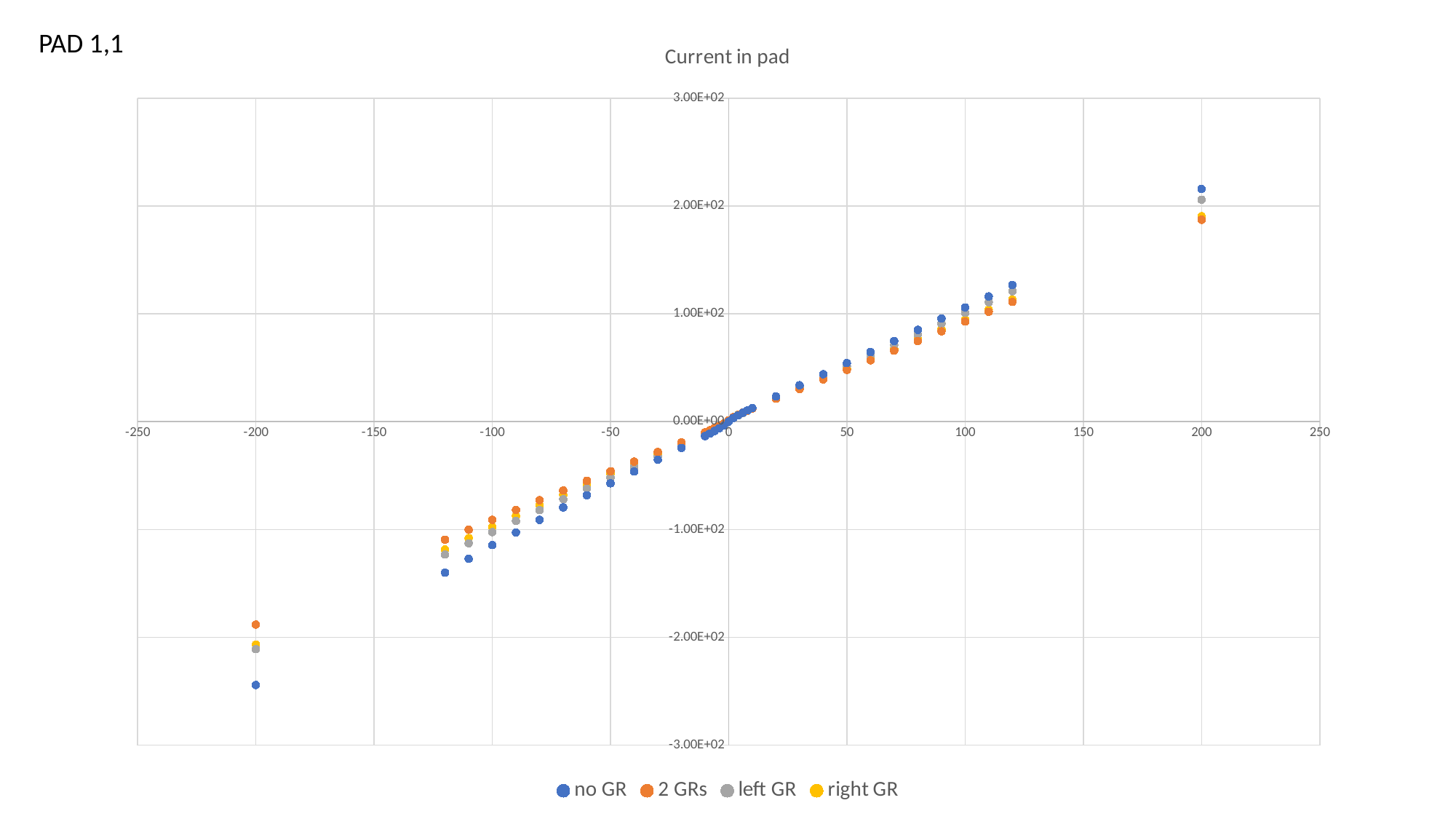
Is the value for the 2 GRs series at x = -200 greater or less than -2.00E+02? greater At x = 200, which series has the highest value? no GR Is the value for the no GR series at x = -200 greater or less than -2.00E+02? less Which series is shown in blue in the legend? no GR How many series does the legend list? 4 Is the value for the no GR series at x = 200 greater or less than 2.00E+02? greater At x = -200, which series has the lowest value? no GR What is the title of the chart? Current in pad Do the values rise or fall as the x axis increases from -200 to 200? rise What kind of chart is shown on the slide? scatter chart